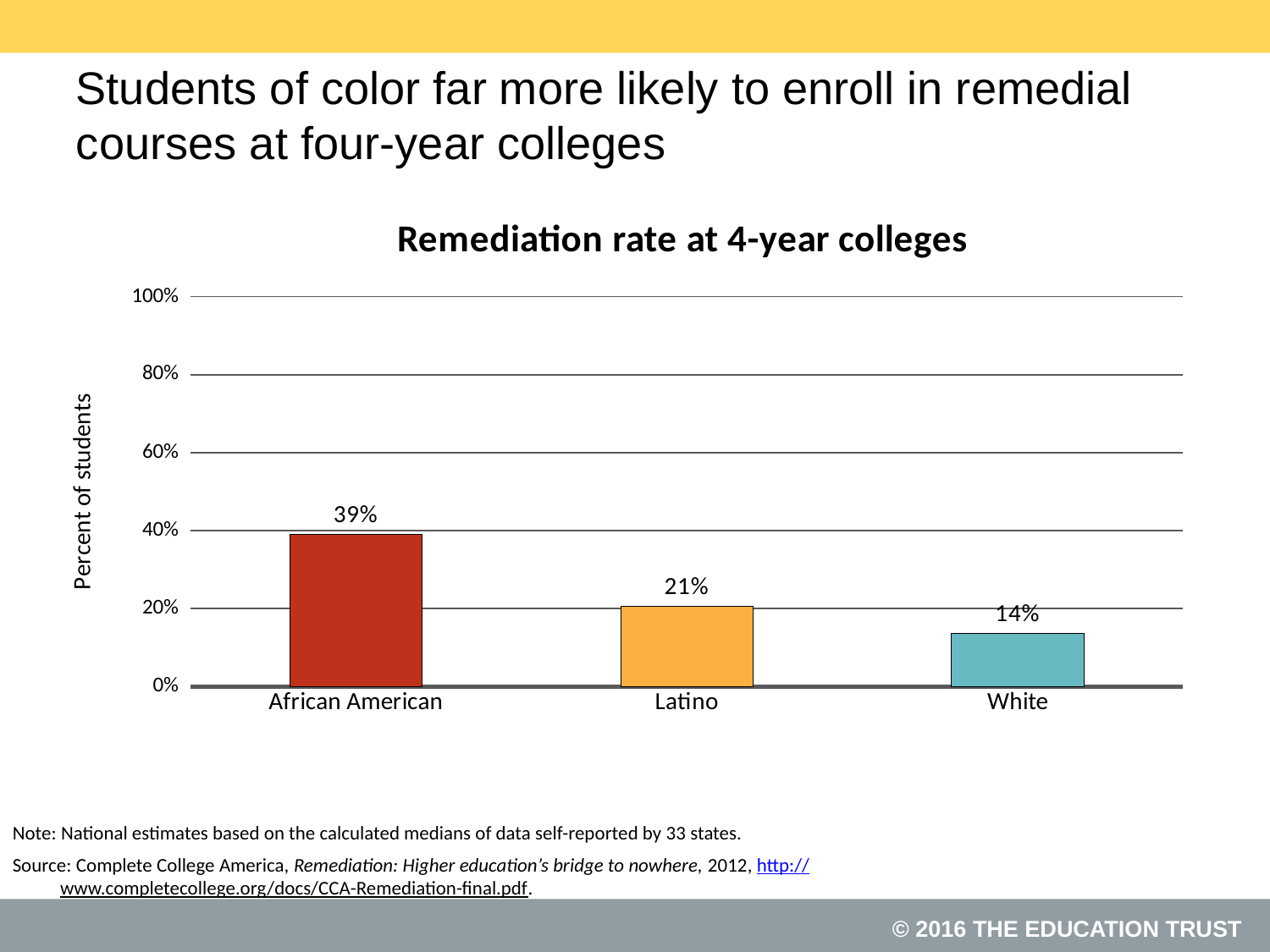
What is the title of the chart? Remediation rate at 4-year colleges What is the remediation rate for White students? 14% Which group has a higher remediation rate, Latino or White? Latino What is the remediation rate for African American students? 39% How many groups are shown in the chart? 3 What is the remediation rate for Latino students? 21% What is the difference in remediation rate between African American and White students? 25% Which group has the lowest remediation rate? White Is the remediation rate for African American students greater or less than 40%? less What kind of chart is shown on the slide? Bar chart Which group has the highest remediation rate? African American What is the difference in remediation rate between Latino and White students? 7%